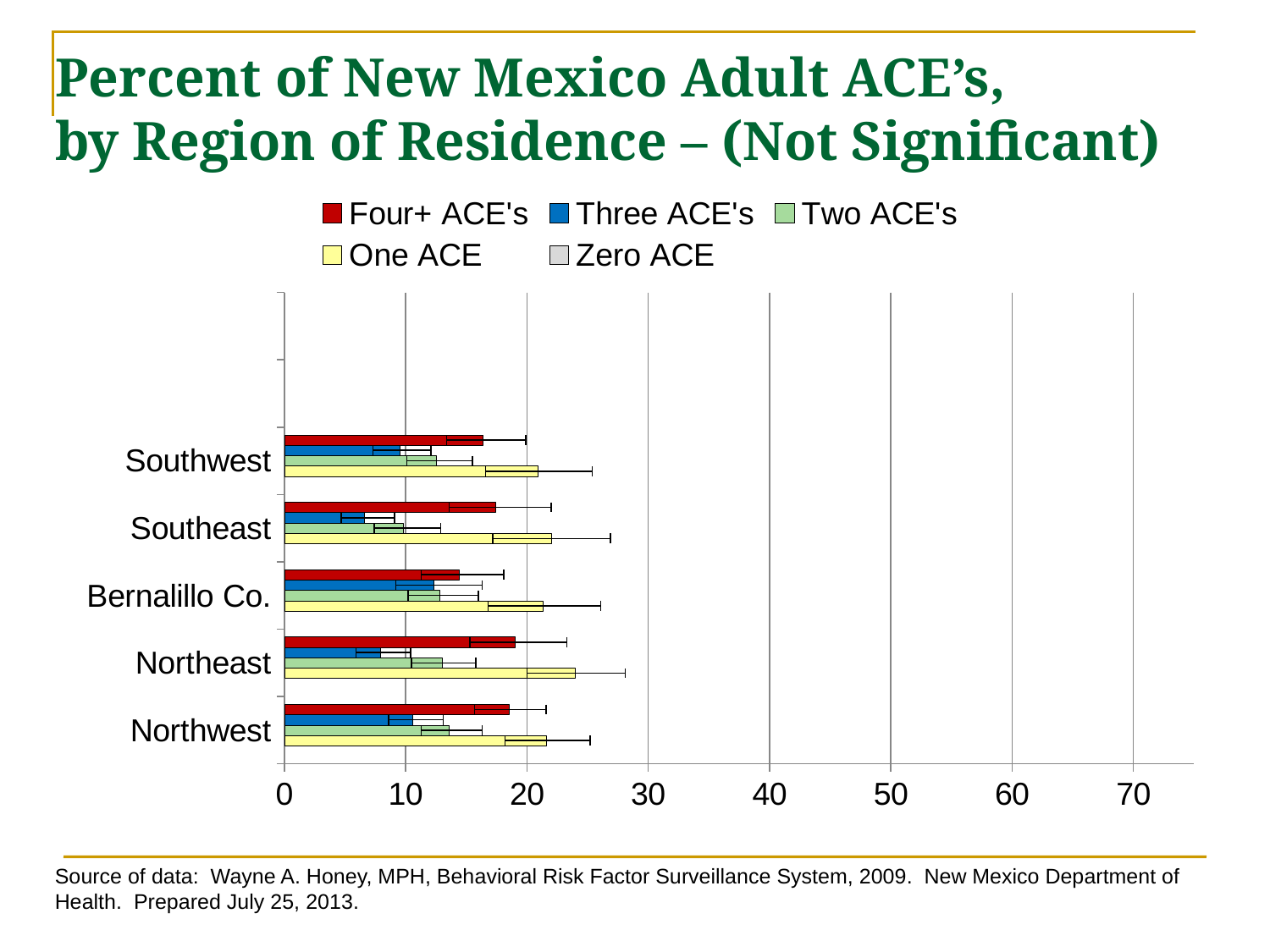
Which is larger: the Three ACE's value for Bernalillo Co. or for Southeast? Bernalillo Co. How many series does the chart's legend list? 5 Which region has the lowest Four+ ACE's value? Bernalillo Co. Is the Four+ ACE's value for Bernalillo Co. greater or less than 20? less What kind of chart is shown on the slide? Bar chart Which series has the longest bar in every region? One ACE Is the One ACE value for Northeast greater or less than 20? greater What is the highest value shown on the chart's horizontal axis? 70 How many regions are shown on the chart's vertical axis? 5 Is the Three ACE's value for Southeast greater or less than 10? less Which region has the highest One ACE value? Northeast